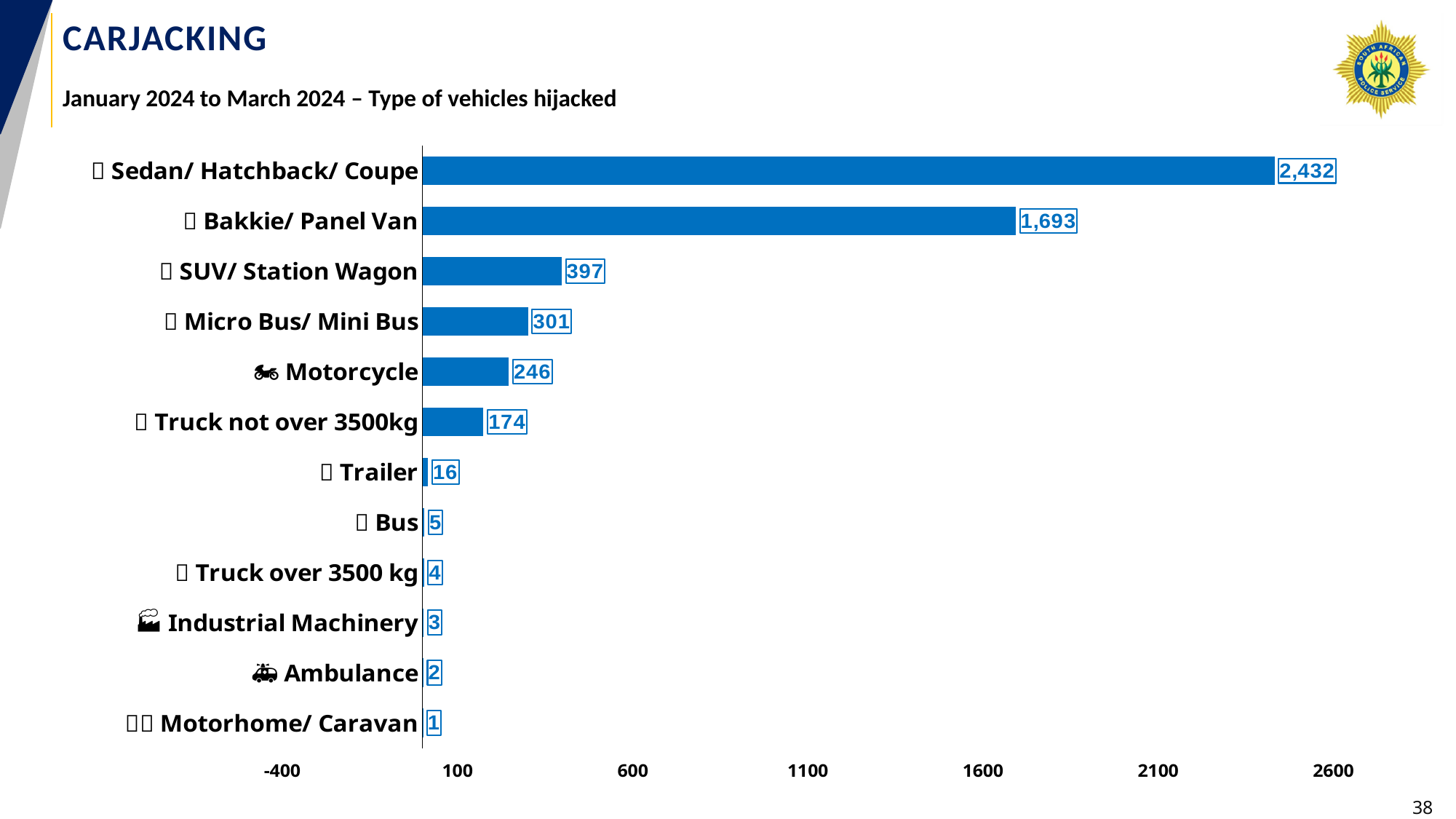
How many vehicle type categories are shown in the chart? 12 What is the difference between the values for Sedan/ Hatchback/ Coupe and Bakkie/ Panel Van? 739 What kind of chart is shown on the slide? Bar chart What is the value shown for Truck not over 3500kg? 174 Which is larger, the value for Micro Bus/ Mini Bus or the value for Motorcycle? Micro Bus/ Mini Bus How many vehicles in the Sedan/ Hatchback/ Coupe category were hijacked? 2,432 What is the subtitle of the chart on the slide? January 2024 to March 2024 – Type of vehicles hijacked What is the difference between the values for SUV/ Station Wagon and Micro Bus/ Mini Bus? 96 Which vehicle type has the lowest number of hijackings? Motorhome/ Caravan Which vehicle type has the highest number of hijackings? Sedan/ Hatchback/ Coupe What is the value shown for Bakkie/ Panel Van? 1,693 What is the value shown for Motorcycle? 246